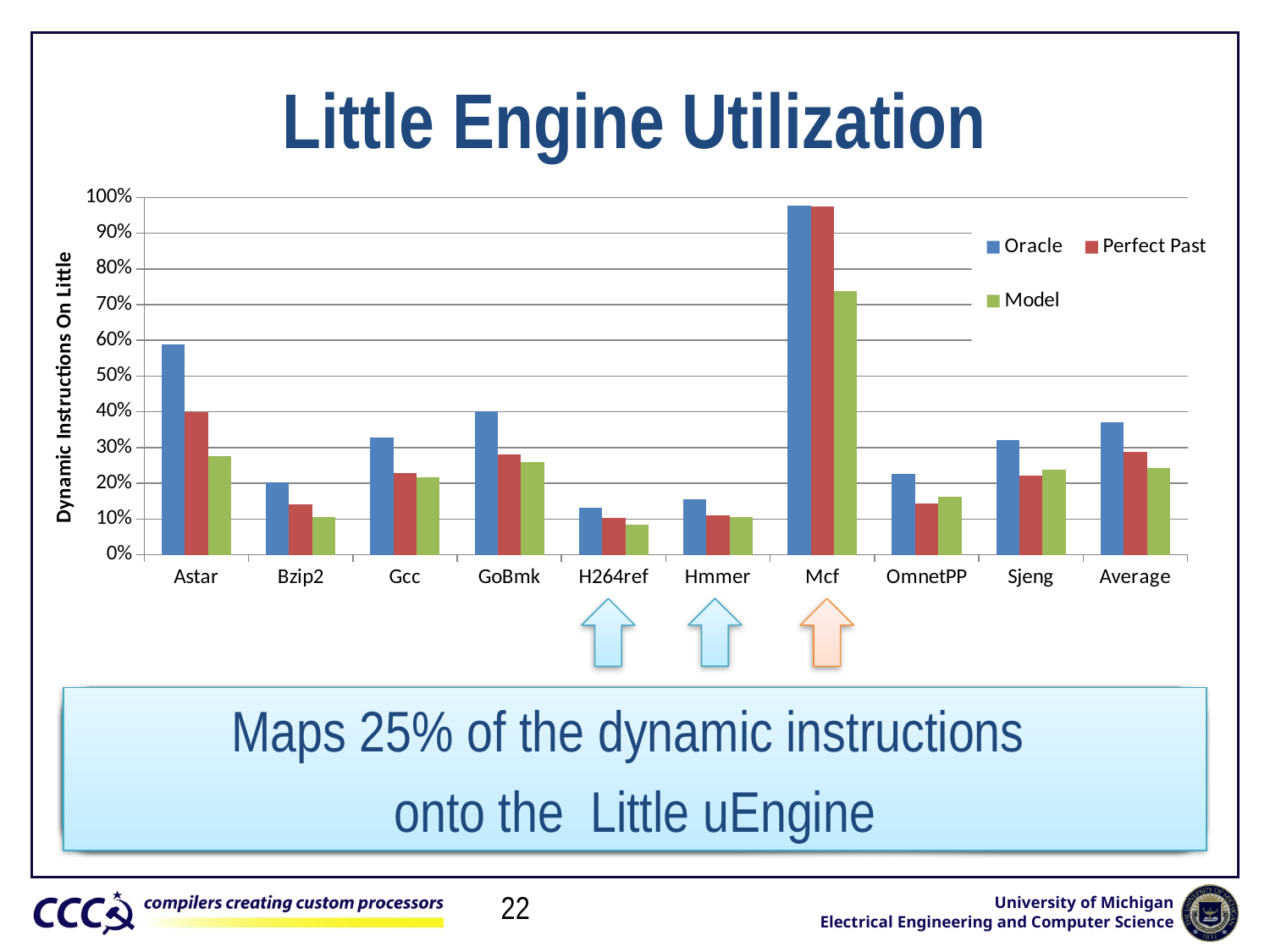
Which category has the highest Model value? Mcf Is the Oracle value for Bzip2 greater or less than 30%? less Is the Oracle value for Mcf greater or less than 90%? greater Is the Oracle value for Astar greater or less than 50%? greater How many categories are shown along the x axis? 10 How many series does the legend list? 3 For Astar, which is larger: the Oracle value or the Perfect Past value? Oracle What is the title of the y axis? Dynamic Instructions On Little Which category has the highest Oracle value? Mcf What kind of chart is shown on the slide? bar chart For Mcf, which is larger: the Perfect Past value or the Model value? Perfect Past